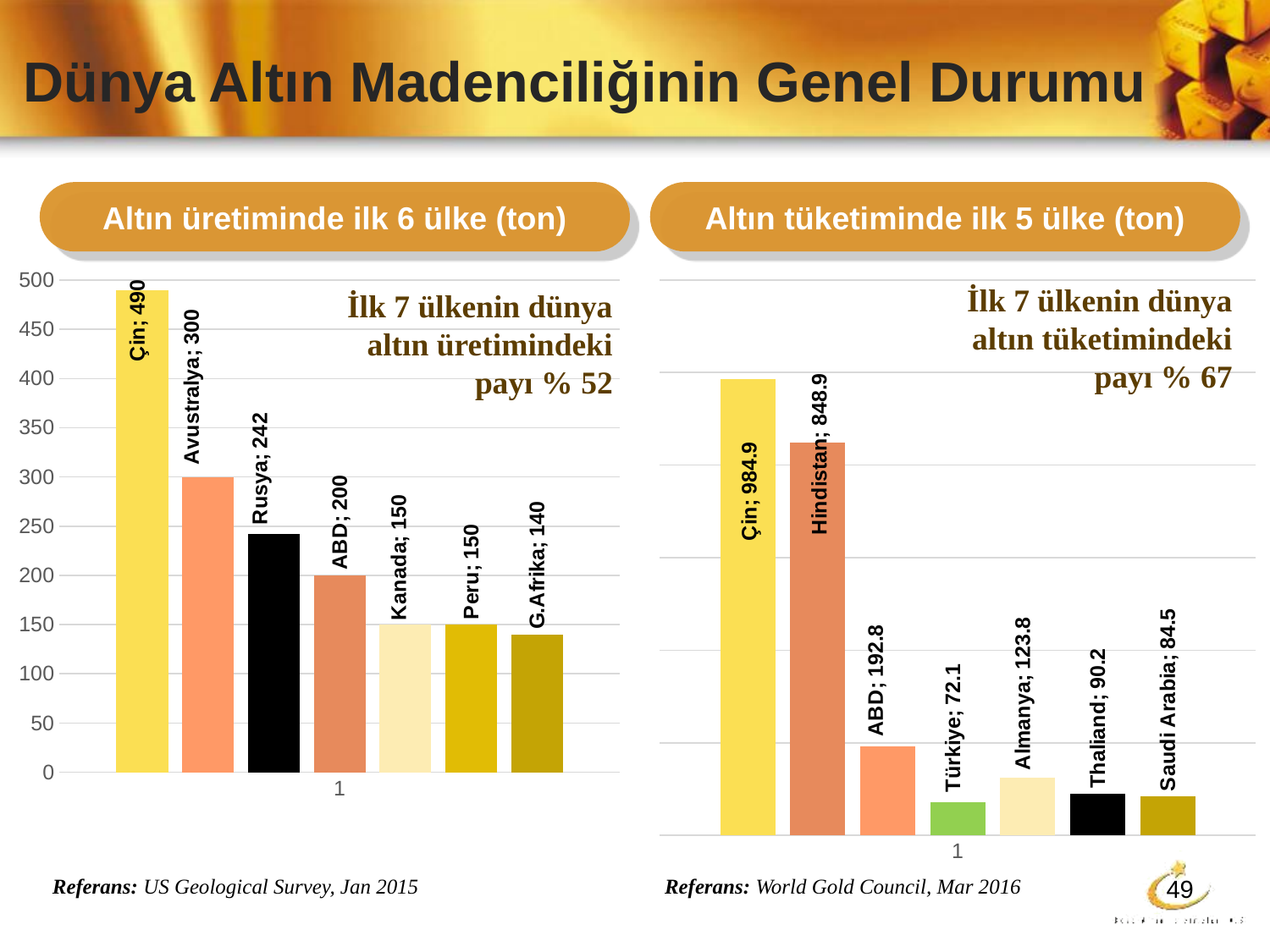
In the 'Altın tüketiminde ilk 5 ülke (ton)' chart, which is larger, Almanya or Thailand? Almanya In the 'Altın üretiminde ilk 6 ülke (ton)' chart, how many bars are plotted? 7 In the 'Altın tüketiminde ilk 5 ülke (ton)' chart, which country has the highest value? Çin What kind of chart is the 'Altın üretiminde ilk 6 ülke (ton)' chart? bar chart In the 'Altın tüketiminde ilk 5 ülke (ton)' chart, what is the value for Türkiye? 72.1 In the 'Altın tüketiminde ilk 5 ülke (ton)' chart, what is the difference between Çin and Hindistan? 136.0 In the 'Altın üretiminde ilk 6 ülke (ton)' chart, which country has the lowest value? G.Afrika In the 'Altın üretiminde ilk 6 ülke (ton)' chart, what is the value for Rusya? 242 In the 'Altın üretiminde ilk 6 ülke (ton)' chart, what is the difference between Çin and Avustralya? 190 According to the text on the 'Altın tüketiminde ilk 5 ülke (ton)' chart, what share of world gold consumption do the top 7 countries have? % 67 In the 'Altın üretiminde ilk 6 ülke (ton)' chart, what is the value for Çin? 490 In the 'Altın tüketiminde ilk 5 ülke (ton)' chart, what is the value for Hindistan? 848.9